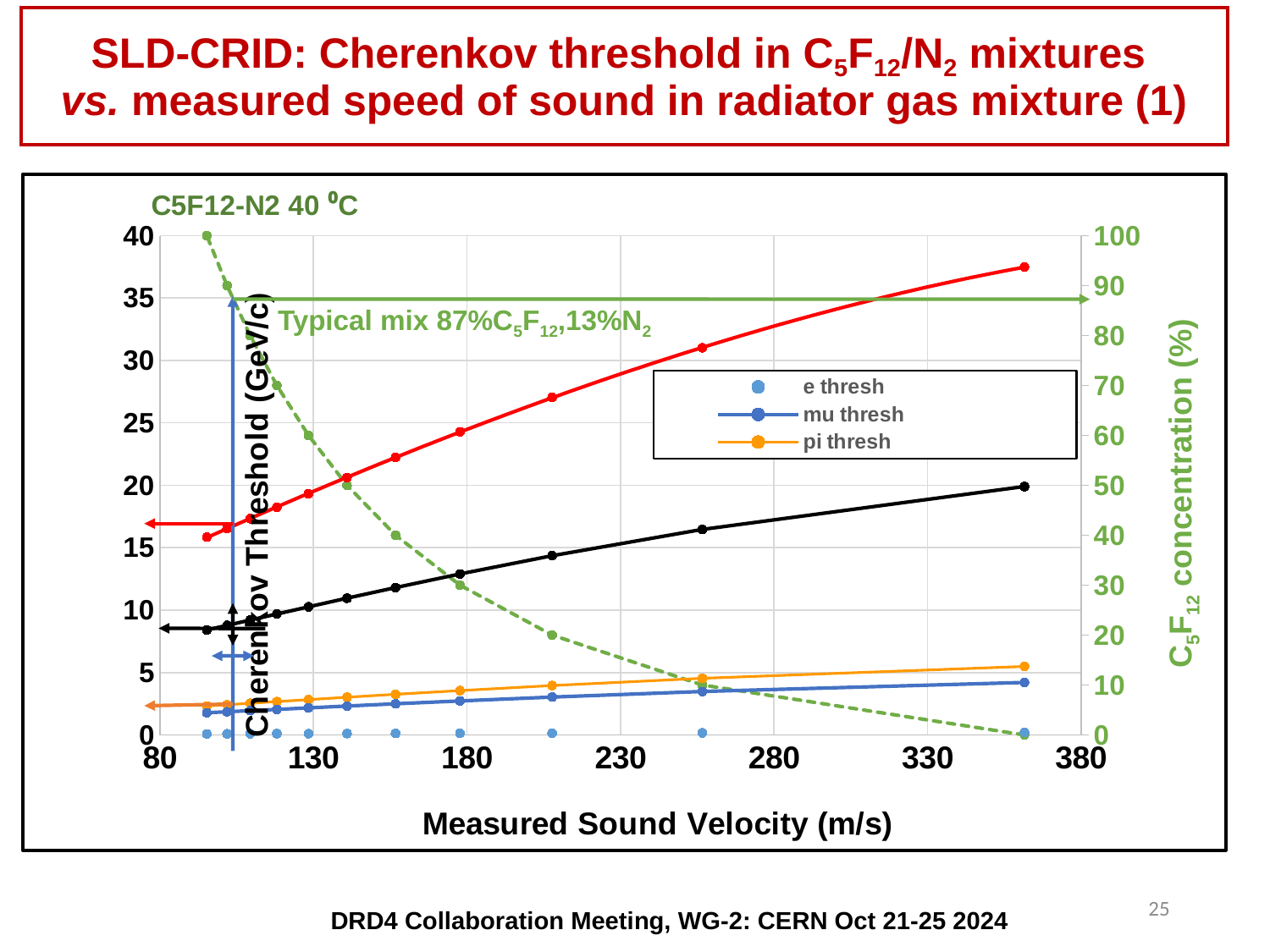
How many series does the legend list? 3 At the highest sound velocity plotted (around 360 m/s), which is larger, the red line or the black line? the red line What kind of chart is shown on the slide? line chart At the highest sound velocity plotted (around 360 m/s), which is larger, pi thresh or mu thresh? pi thresh At the highest sound velocity plotted (around 360 m/s), is the value of the black line greater or less than 15? greater At the highest sound velocity plotted (around 360 m/s), is the value of the mu thresh series greater or less than 5? less Does the green dashed line rise or fall as the measured sound velocity increases? fall What is the title of the right-hand y axis? C5F12 concentration (%) At the highest sound velocity plotted (around 360 m/s), is the value of the red line greater or less than 35? greater Does the red line rise or fall as the measured sound velocity increases? rise What is the title of the x axis? Measured Sound Velocity (m/s)